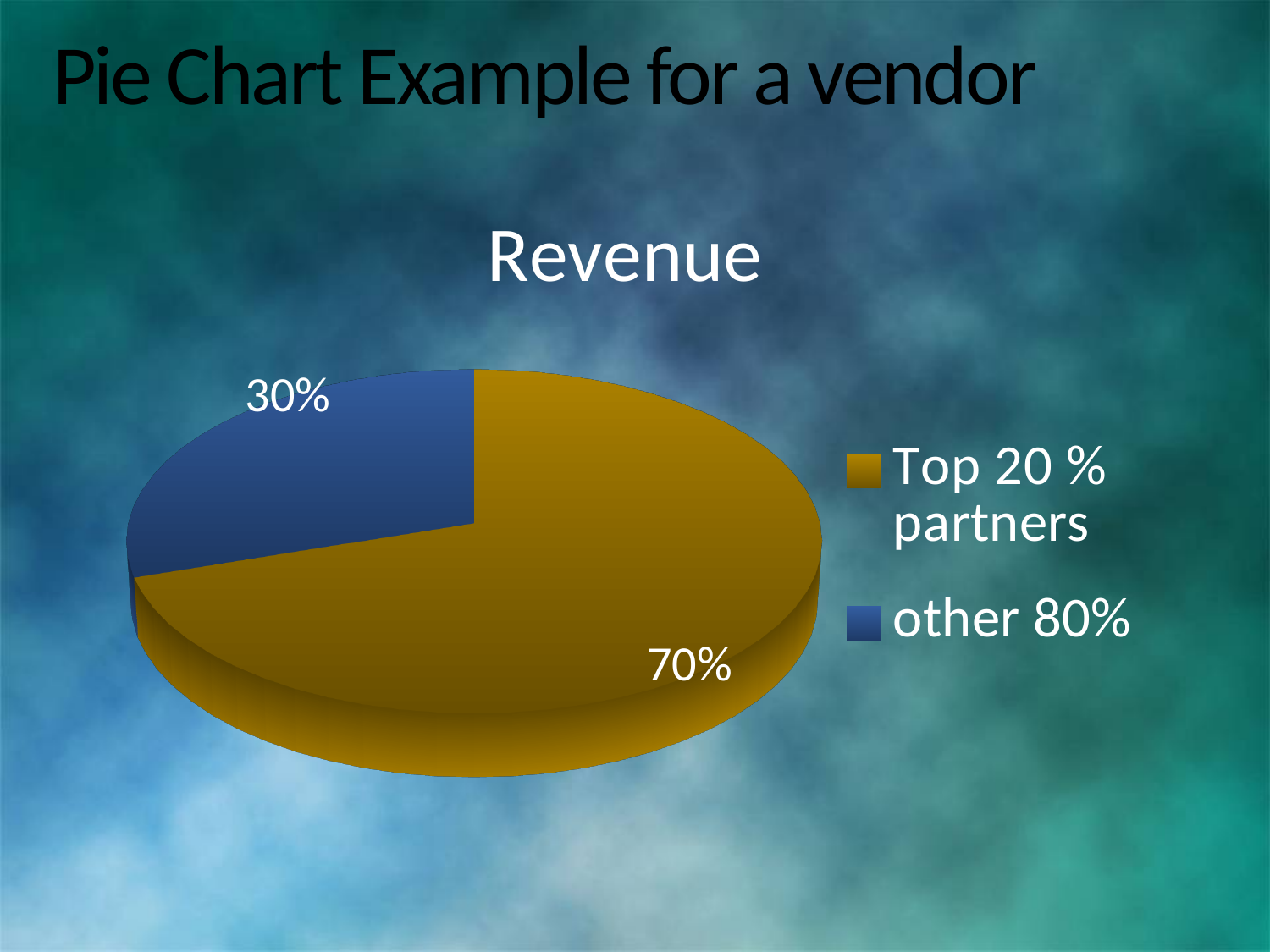
Which slice of the pie is the smallest? other 80% Which slice of the pie is the largest? Top 20 % partners What kind of chart is shown on the slide? pie chart What share of revenue comes from Top 20 % partners? 70% What share of revenue comes from other 80%? 30% What colour is the slice for other 80%? blue How many slices does the pie chart have? 2 How many entries does the legend list? 2 Which is larger, the share for Top 20 % partners or the share for other 80%? Top 20 % partners Is the share for Top 20 % partners greater or less than 50%? greater What is the title of the chart? Revenue What is the difference in percentage points between the Top 20 % partners slice and the other 80% slice? 40